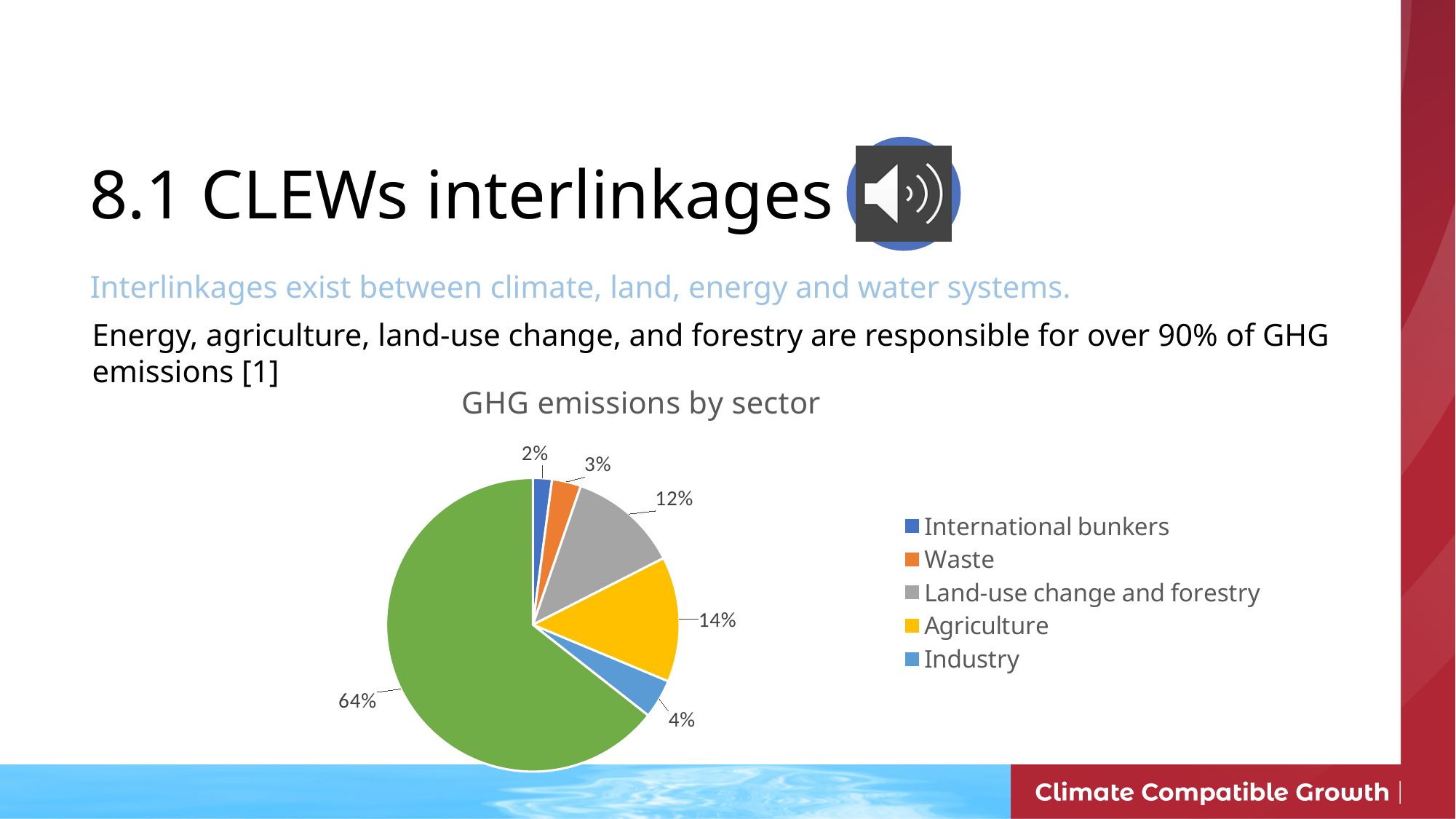
Which has the larger share, Agriculture or Land-use change and forestry? Agriculture What percentage of GHG emissions is attributed to International bunkers? 2% How many percentage points larger is Agriculture's share than Industry's? 10% What is the share for Waste in the GHG emissions by sector chart? 3% What share of GHG emissions does Agriculture account for in the pie chart? 14% What percentage is labelled on the largest slice of the pie chart? 64% What share does Industry have in the pie chart? 4% How many entries does the chart legend list? 5 What percentage is shown for Land-use change and forestry? 12% What type of chart is shown on the slide? Pie chart What is the difference between the shares of Land-use change and forestry and Waste? 9% Which sector has the smallest slice in the pie chart? International bunkers